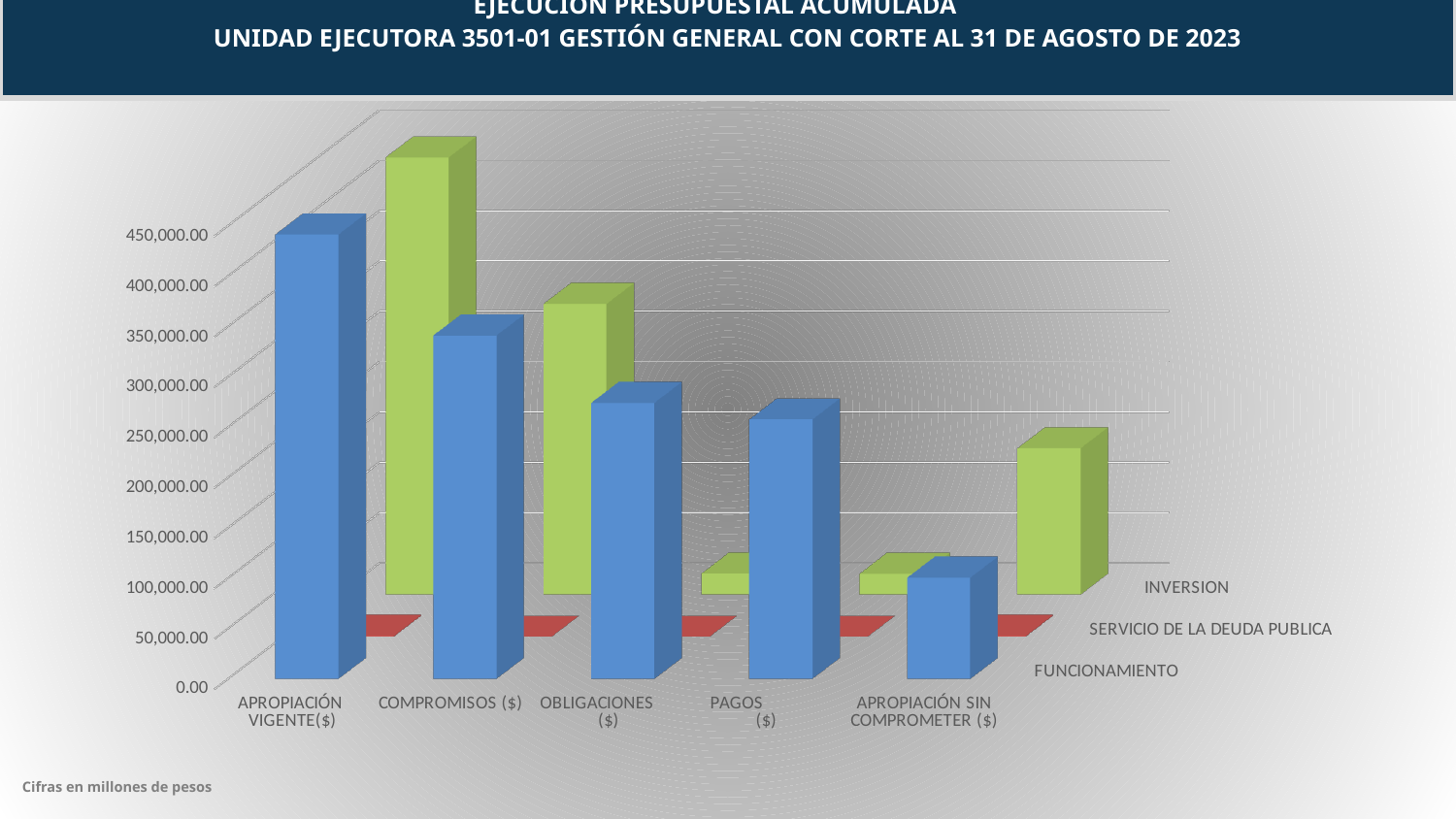
Which series is shown in green? INVERSION Which category has the highest value for the INVERSION series? APROPIACIÓN VIGENTE($) Which category has the lowest value for the FUNCIONAMIENTO series? APROPIACIÓN SIN COMPROMETER ($) How many series does the legend list? 3 Which category has the highest value for the FUNCIONAMIENTO series? APROPIACIÓN VIGENTE($) What type of chart is shown on the slide? Bar chart Do the FUNCIONAMIENTO values rise or fall from APROPIACIÓN VIGENTE($) to APROPIACIÓN SIN COMPROMETER ($)? fall How many categories are shown along the x axis? 5 For the FUNCIONAMIENTO series, which is larger: COMPROMISOS ($) or PAGOS ($)? COMPROMISOS ($) Is the FUNCIONAMIENTO value for APROPIACIÓN SIN COMPROMETER ($) greater or less than 150,000.00? less For the INVERSION series, which is larger: COMPROMISOS ($) or APROPIACIÓN SIN COMPROMETER ($)? COMPROMISOS ($) Is the FUNCIONAMIENTO value for APROPIACIÓN VIGENTE($) greater or less than 400,000.00? greater